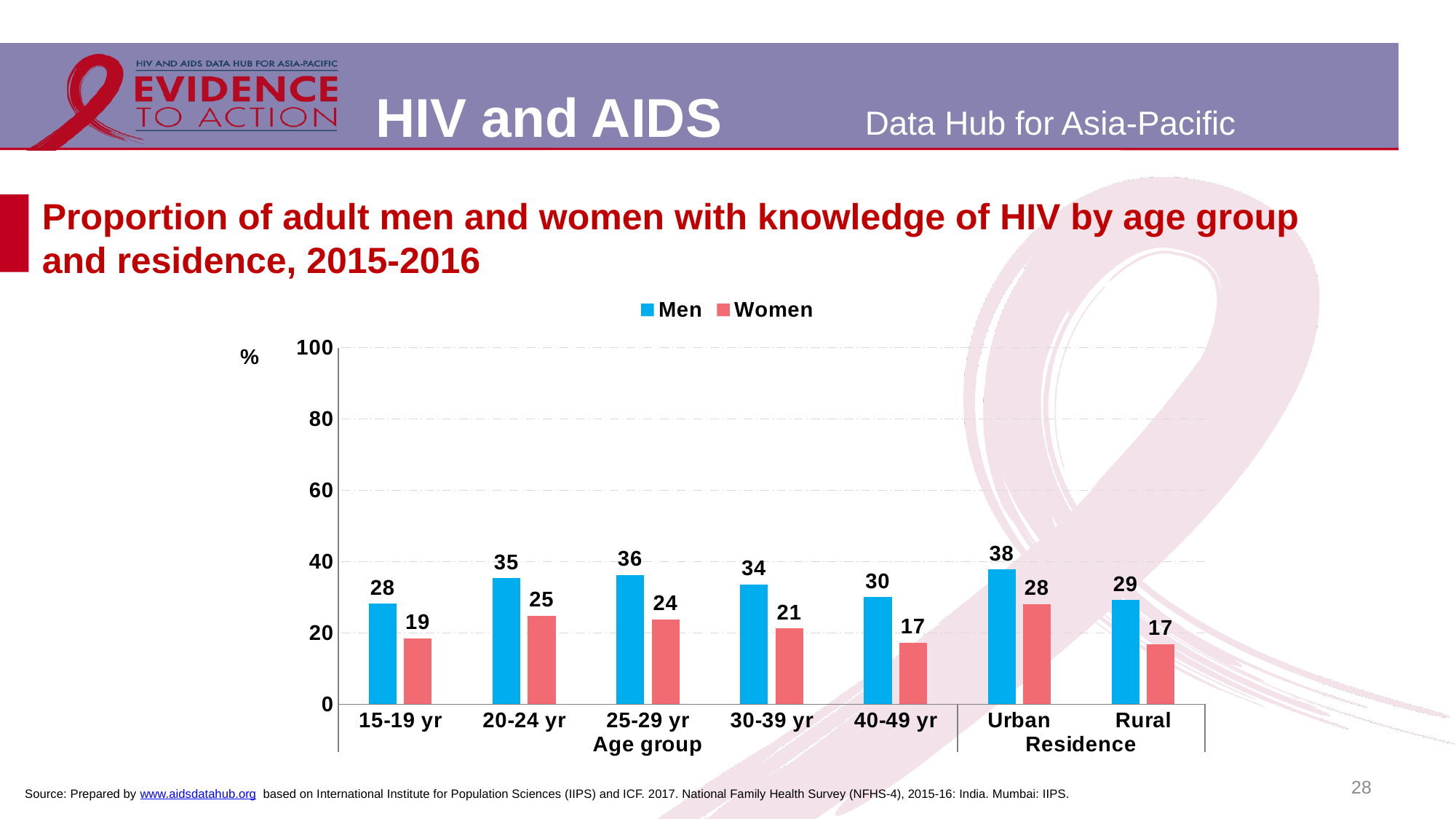
What is the value for Men in the 15-19 yr age group? 28 What is the value for Women in the Urban residence category? 28 What is the value for Women in the 30-39 yr age group? 21 How many categories are shown on the x axis? 7 What is the difference between the Men and Women values for the Rural category? 12 Is the value for Men in the Urban category greater or less than 40? less Which colour represents Women in the chart? red Which category has the highest value for Men? Urban Which age group has the lowest value for Women? 40-49 yr What kind of chart is shown on the slide? bar chart How many series does the legend list? 2 Which is larger: the Men value for 20-24 yr or the Men value for 25-29 yr? 25-29 yr